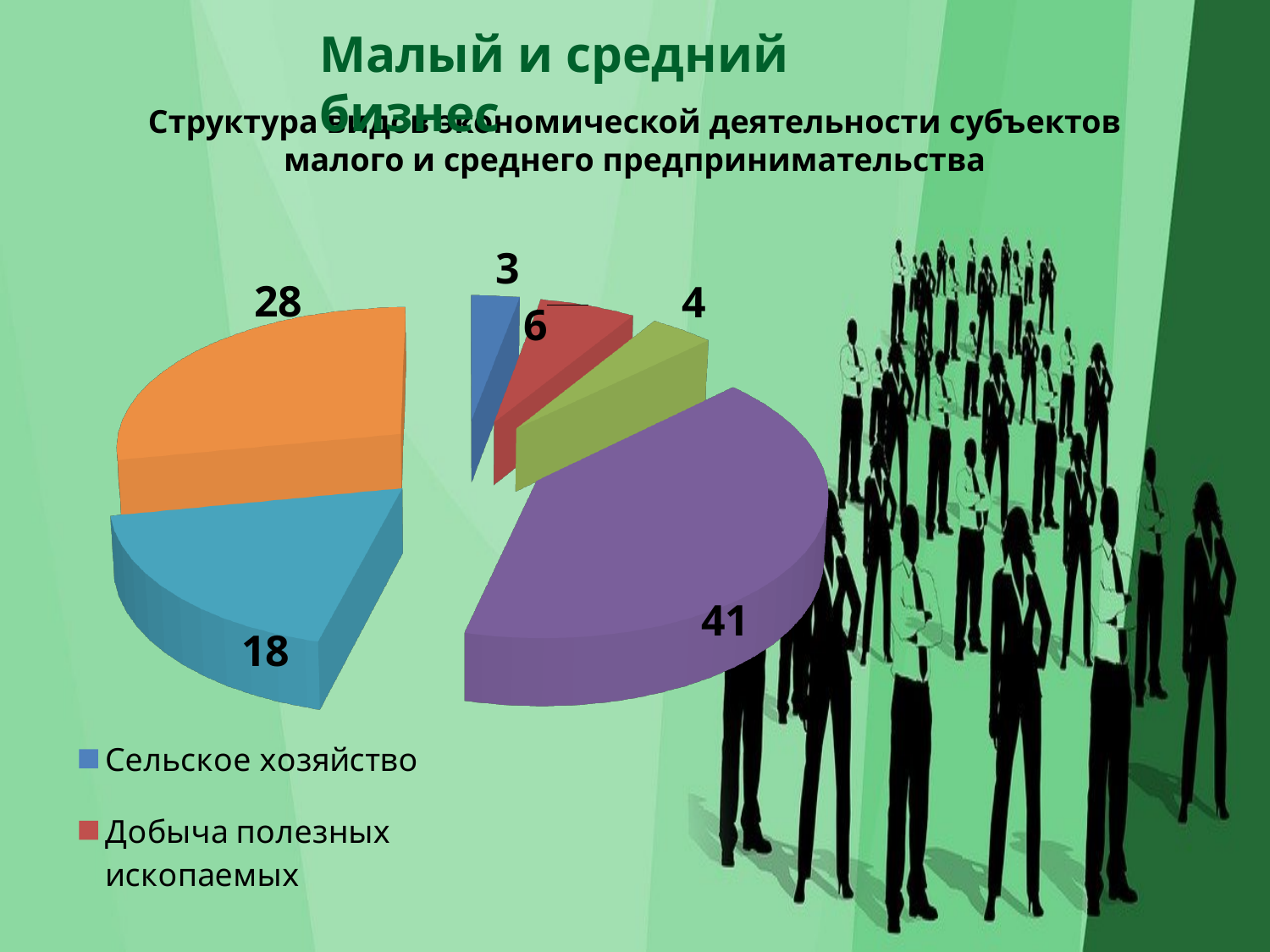
What share of the pie does the largest slice represent? 41% What is the value of the slice for Добыча полезных ископаемых? 6 Which is larger, the slice for Сельское хозяйство or the slice for Добыча полезных ископаемых? Добыча полезных ископаемых What is the value of the slice for Сельское хозяйство? 3 What colour is the slice for Сельское хозяйство? blue Which legend category has the smallest slice in the pie chart? Сельское хозяйство What is the title of the pie chart? Структура видов экономической деятельности субъектов малого и среднего предпринимательства What type of chart is shown on the slide? pie chart What share of the pie does the slice for Сельское хозяйство represent? 3% What is the difference between the values for Добыча полезных ископаемых and Сельское хозяйство? 3 How many slices does the pie chart have? 6 What is the value of the largest slice in the pie chart? 41